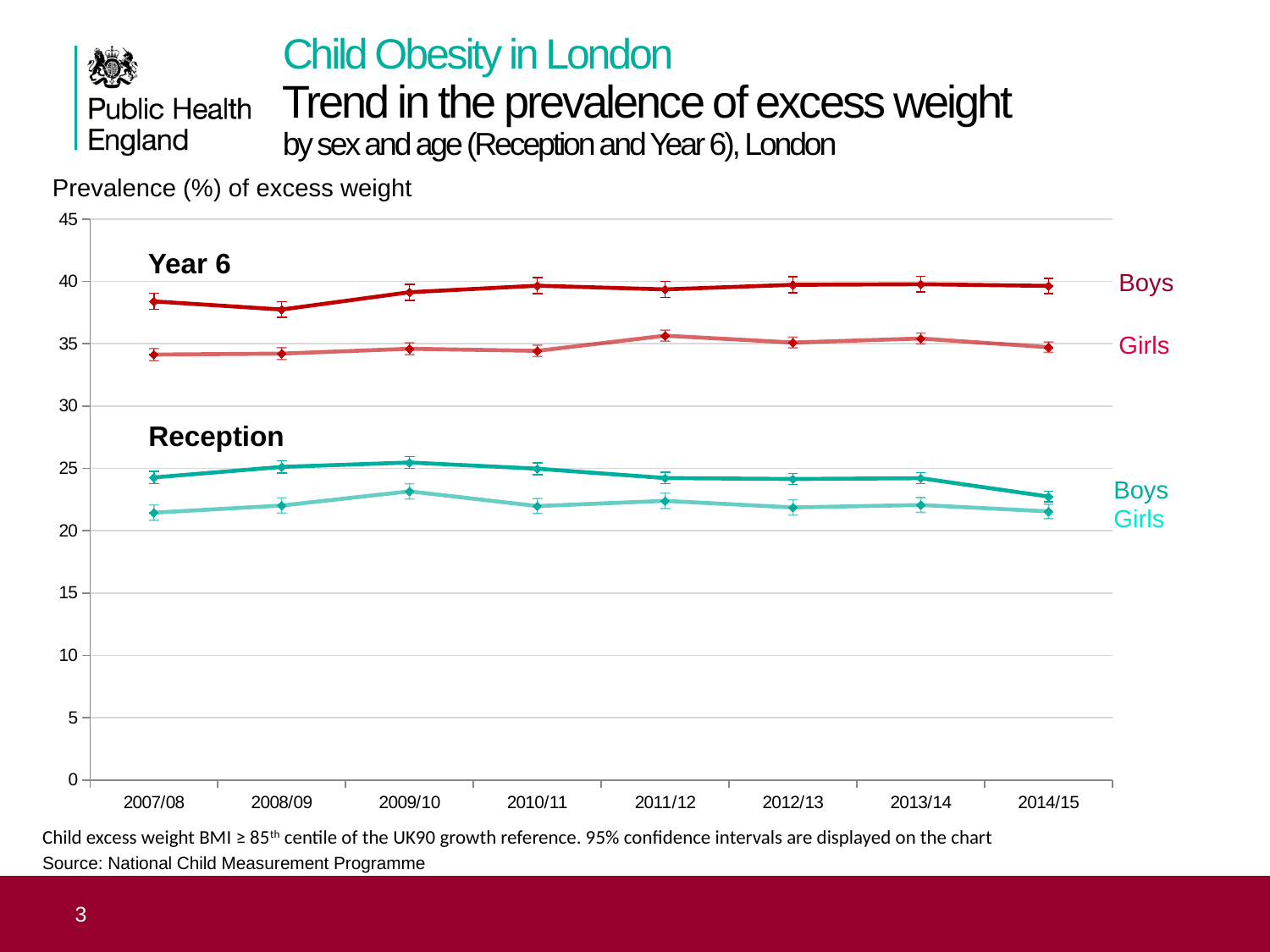
What kind of chart is shown on the slide? Line chart Is the Year 6 Girls value for 2007/08 greater or less than 35? less How many school years are shown along the x axis of the chart? 8 In 2014/15, which is larger: the Year 6 Boys value or the Year 6 Girls value? Year 6 Boys Is the Reception Boys value for 2009/10 greater or less than 25? greater What is the label given for the vertical axis of the chart? Prevalence (%) of excess weight Is the Reception Girls value for 2007/08 greater or less than 20? greater In which school year does the Reception Boys line reach its highest point? 2009/10 Does the Reception Boys line rise or fall between 2009/10 and 2014/15? Fall How many series (lines) are plotted on the chart? 4 In which school year does the Year 6 Boys line reach its lowest point? 2008/09